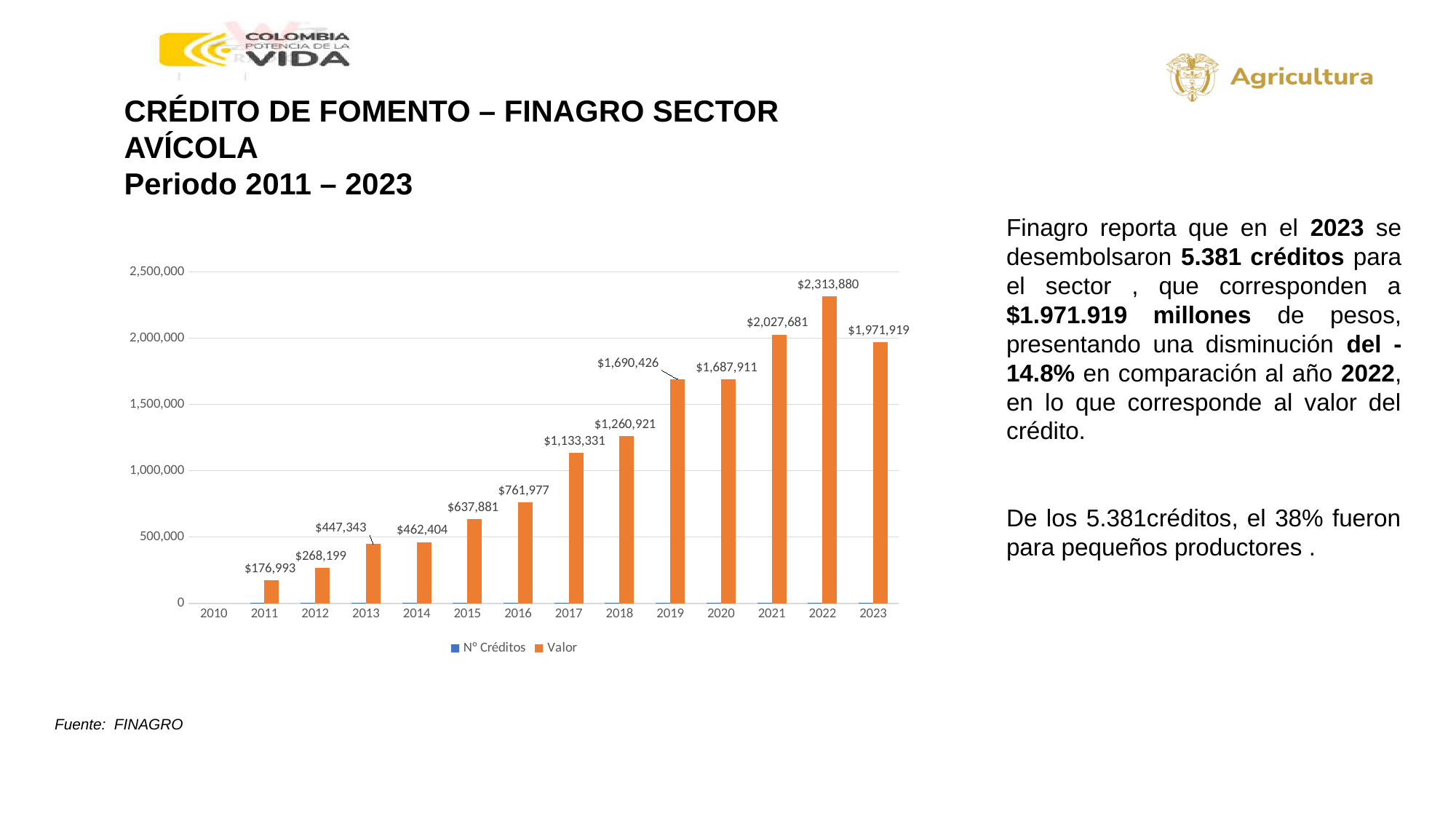
Which is larger, the Valor for 2013 or the Valor for 2014? 2014 How many series does the legend list? 2 How many years are shown on the x axis? 14 What is the difference between the Valor for 2022 and the Valor for 2023? $341,961 Is the Valor for 2017 greater or less than 1,000,000? greater What kind of chart is shown on the slide? bar chart Does the Valor generally rise or fall from 2011 to 2022? rise Among the years with a labeled Valor, which year has the lowest value? 2011 Which year has the highest Valor? 2022 What is the Valor for 2019? $1,690,426 What is the Valor for 2023? $1,971,919 What is the Valor for 2015? $637,881